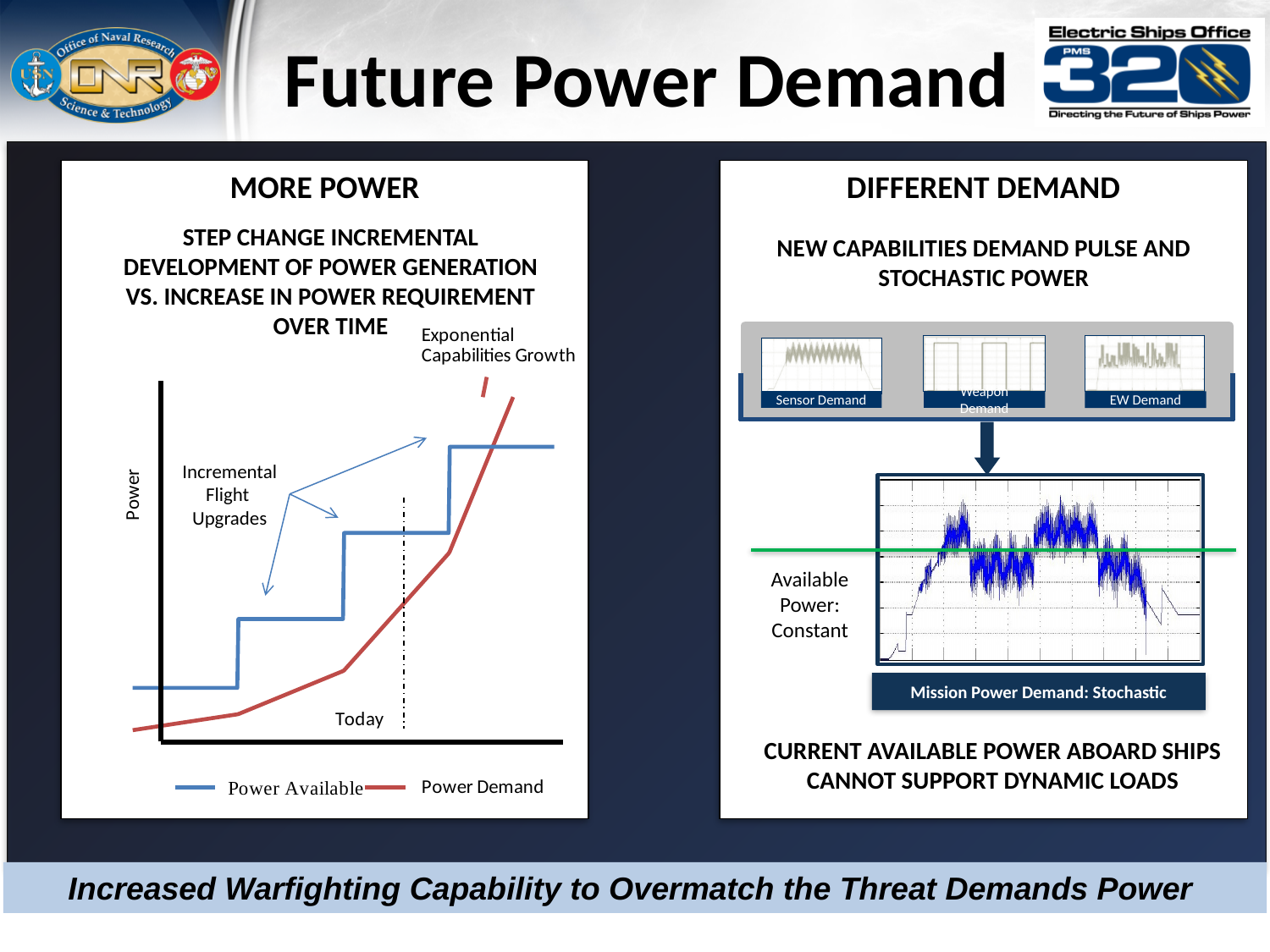
On the MORE POWER chart, how many series does the legend list? 2 On the MORE POWER chart, at the far right of the plot, which series is higher, Power Available or Power Demand? Power Demand On the MORE POWER chart, at the point marked Today, which series is higher, Power Available or Power Demand? Power Available On the MORE POWER chart, which series is drawn as a series of steps, Power Available or Power Demand? Power Available On the MORE POWER chart, what kind of chart is shown? Line chart On the DIFFERENT DEMAND panel, how many small demand waveform images are shown in the top row? 3 On the MORE POWER chart, what is the label on the vertical axis? Power On the MORE POWER chart, does the Power Demand line rise or fall along the x axis? Rise On the MORE POWER chart, what colour is the Power Demand line? Red On the DIFFERENT DEMAND panel, what does the green horizontal line across the stochastic plot represent? Available Power: Constant On the MORE POWER chart, does the Power Available line generally rise or fall from left to right? Rise